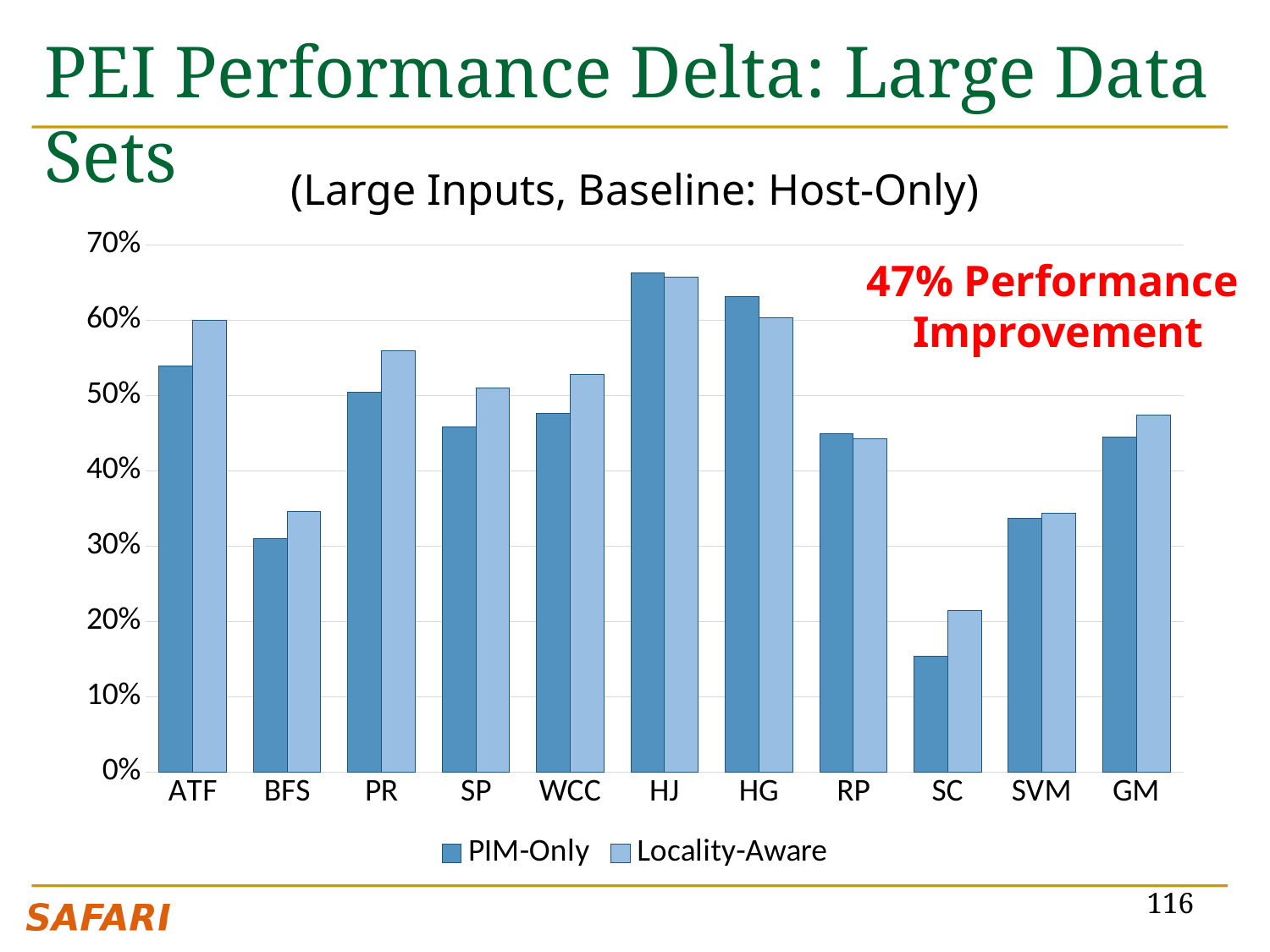
Is the PIM-Only value for ATF greater or less than 50%? greater Is the PIM-Only value for HJ greater or less than 60%? greater What kind of chart is shown on the slide? bar chart Is the Locality-Aware value for GM greater or less than 50%? less For HG, which series has the larger value, PIM-Only or Locality-Aware? PIM-Only What is the subtitle shown above the chart? (Large Inputs, Baseline: Host-Only) Which category has the lowest Locality-Aware value? SC Which category has the highest PIM-Only value? HJ How many categories are shown on the x axis? 11 How many series does the legend list? 2 For PR, which series has the larger value, PIM-Only or Locality-Aware? Locality-Aware